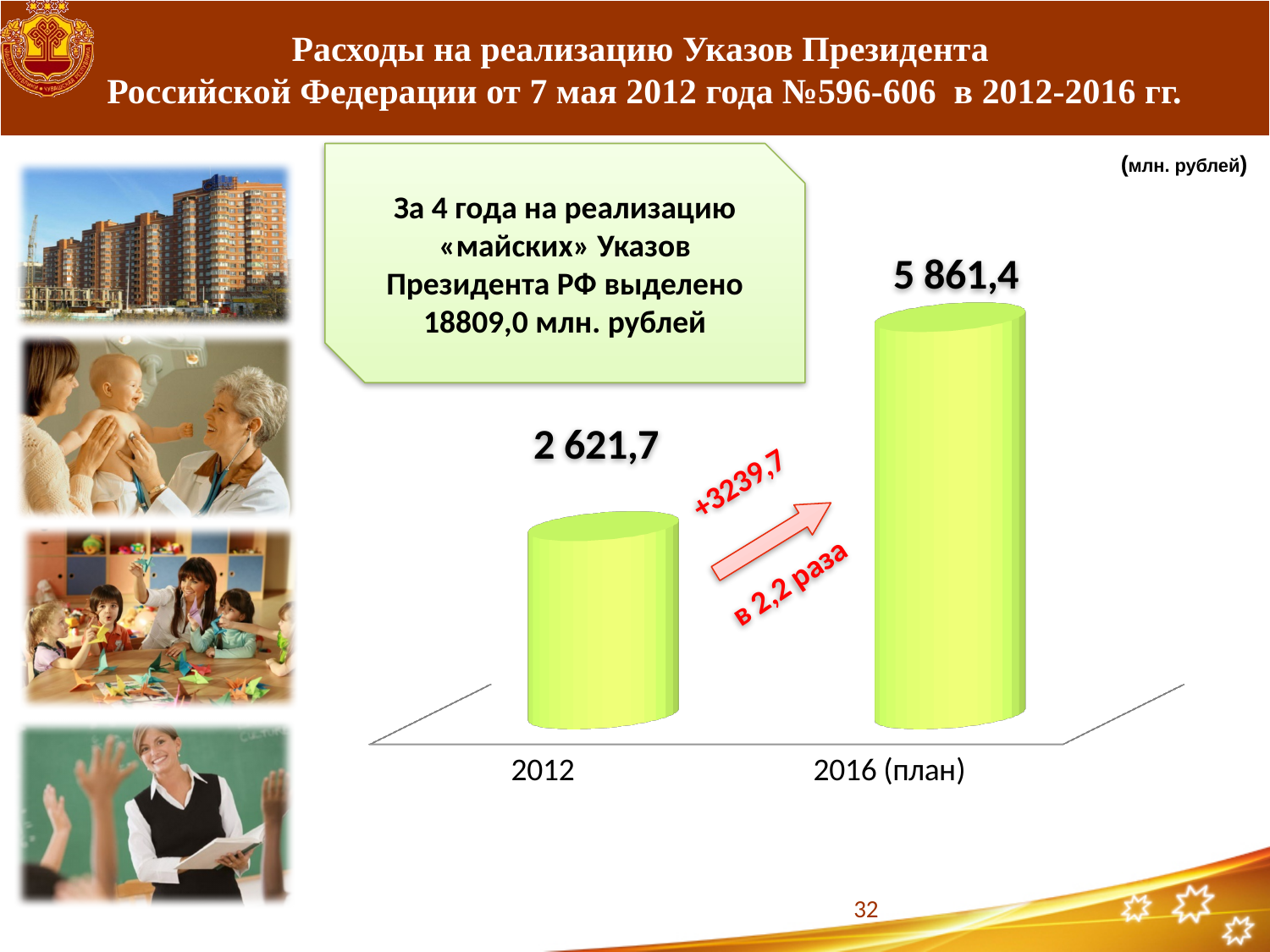
Which is larger, the value for 2012 or the value for 2016 (план)? 2016 (план) What is the value for 2012? 2 621,7 How many categories are shown on the chart? 2 What is the value for 2016 (план)? 5 861,4 What unit of measurement is indicated for the chart values? млн. рублей Do the values rise or fall from 2012 to 2016 (план)? rise Which category has the highest value? 2016 (план) What is the difference between the values for 2016 (план) and 2012? 3239,7 What kind of chart is shown on the slide? bar chart By what factor does the chart say the value increased from 2012 to 2016 (план)? в 2,2 раза Which category has the lowest value? 2012